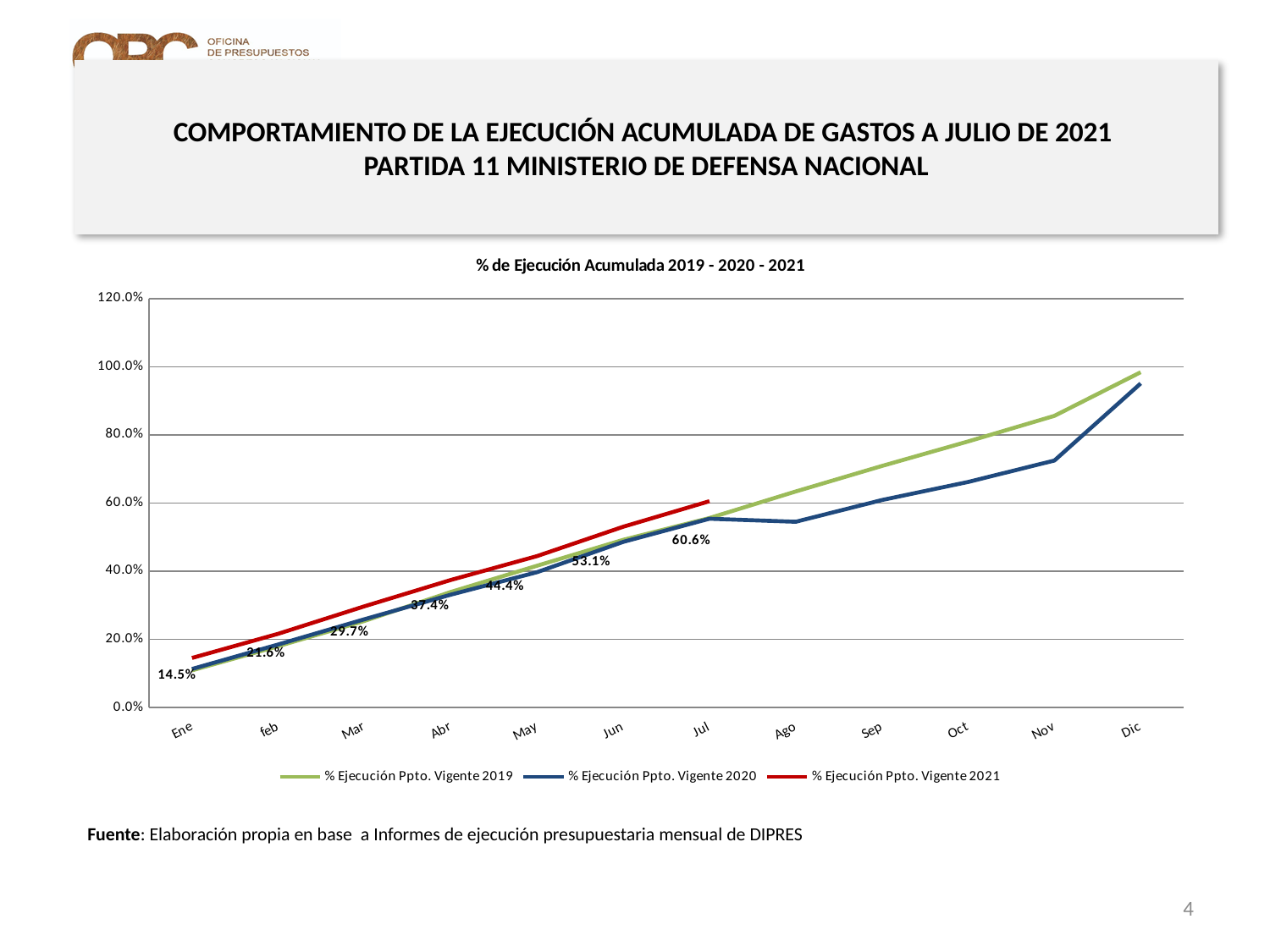
In which month does % Ejecución Ppto. Vigente 2021 reach its highest value? Jul What is the title of the chart? % de Ejecución Acumulada 2019 - 2020 - 2021 What is the difference between the % Ejecución Ppto. Vigente 2021 values for Jul and Ene? 46.1% What kind of chart is shown on the slide? Line chart How many months are shown on the x axis? 12 What is the value for % Ejecución Ppto. Vigente 2021 in Ene? 14.5% What is the value for % Ejecución Ppto. Vigente 2021 in Abr? 37.4% What is the value for % Ejecución Ppto. Vigente 2021 in Jul? 60.6% Is the value for % Ejecución Ppto. Vigente 2019 in Dic greater or less than 80.0%? greater In which month is % Ejecución Ppto. Vigente 2021 lowest? Ene How many series does the legend list? 3 In Nov, which series is higher: % Ejecución Ppto. Vigente 2019 or % Ejecución Ppto. Vigente 2020? % Ejecución Ppto. Vigente 2019